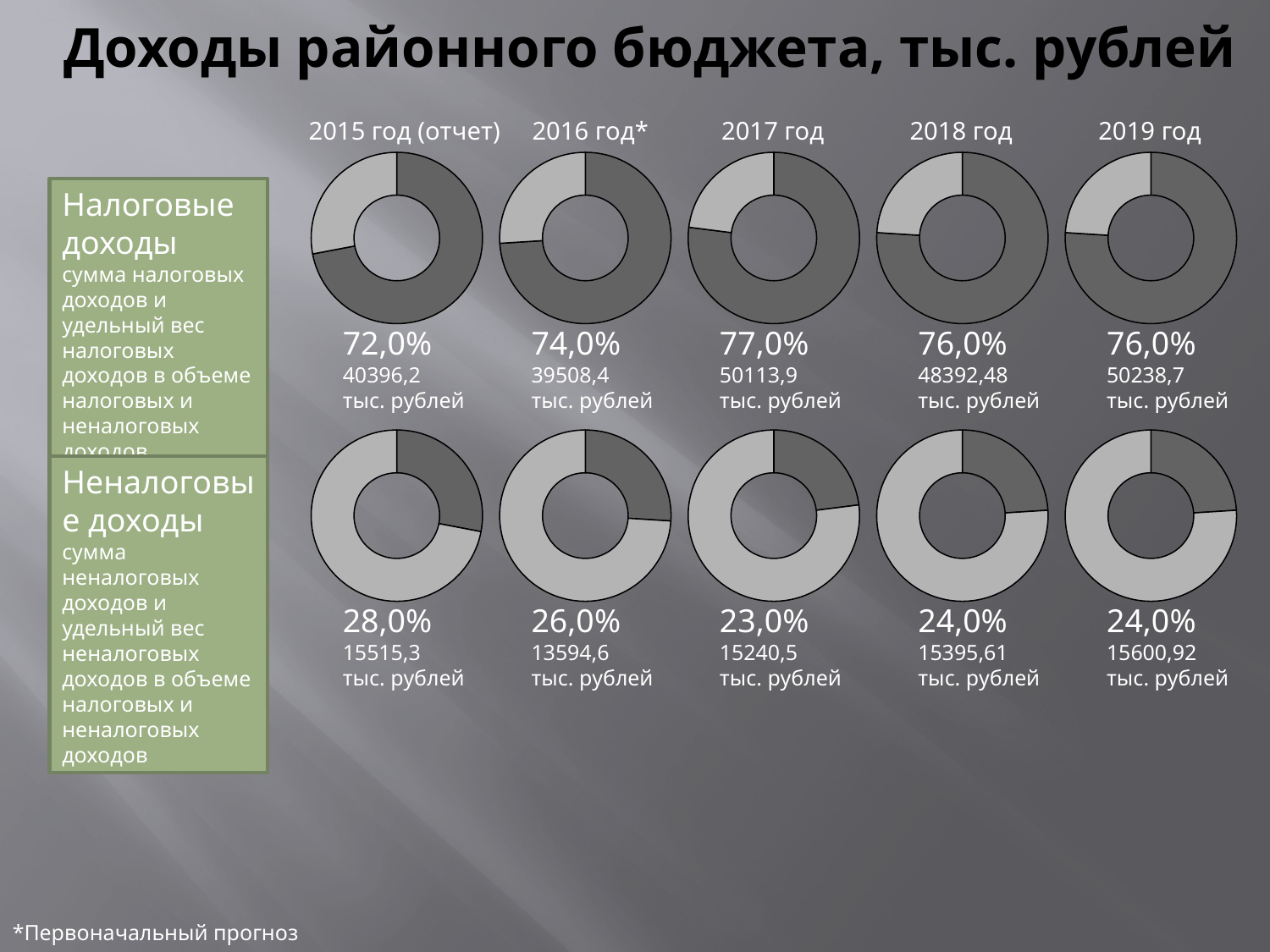
What is the amount of non-tax revenues (Неналоговые доходы) shown for 2019 год? 15600,92 тыс. рублей What type of chart is used on this slide? Donut (pie) chart What is the combined share of tax and non-tax revenues for 2018 год? 100,0% In which year is the share of non-tax revenues (Неналоговые доходы) the lowest? 2017 год By how many percentage points does the tax revenue share in 2017 год exceed that in 2016 год*? 3,0 What is the title of the slide? Доходы районного бюджета, тыс. рублей How many donut charts are shown on the slide? 10 What is the amount of tax revenues (Налоговые доходы) shown for 2017 год? 50113,9 тыс. рублей In which year is the share of tax revenues (Налоговые доходы) the highest? 2017 год What share of revenues do tax revenues (Налоговые доходы) make up in 2015 год (отчет)? 72,0% Which is larger: the non-tax revenue amount in 2015 год (отчет) or in 2016 год*? 2015 год (отчет) What share of revenues do non-tax revenues (Неналоговые доходы) make up in 2016 год*? 26,0%